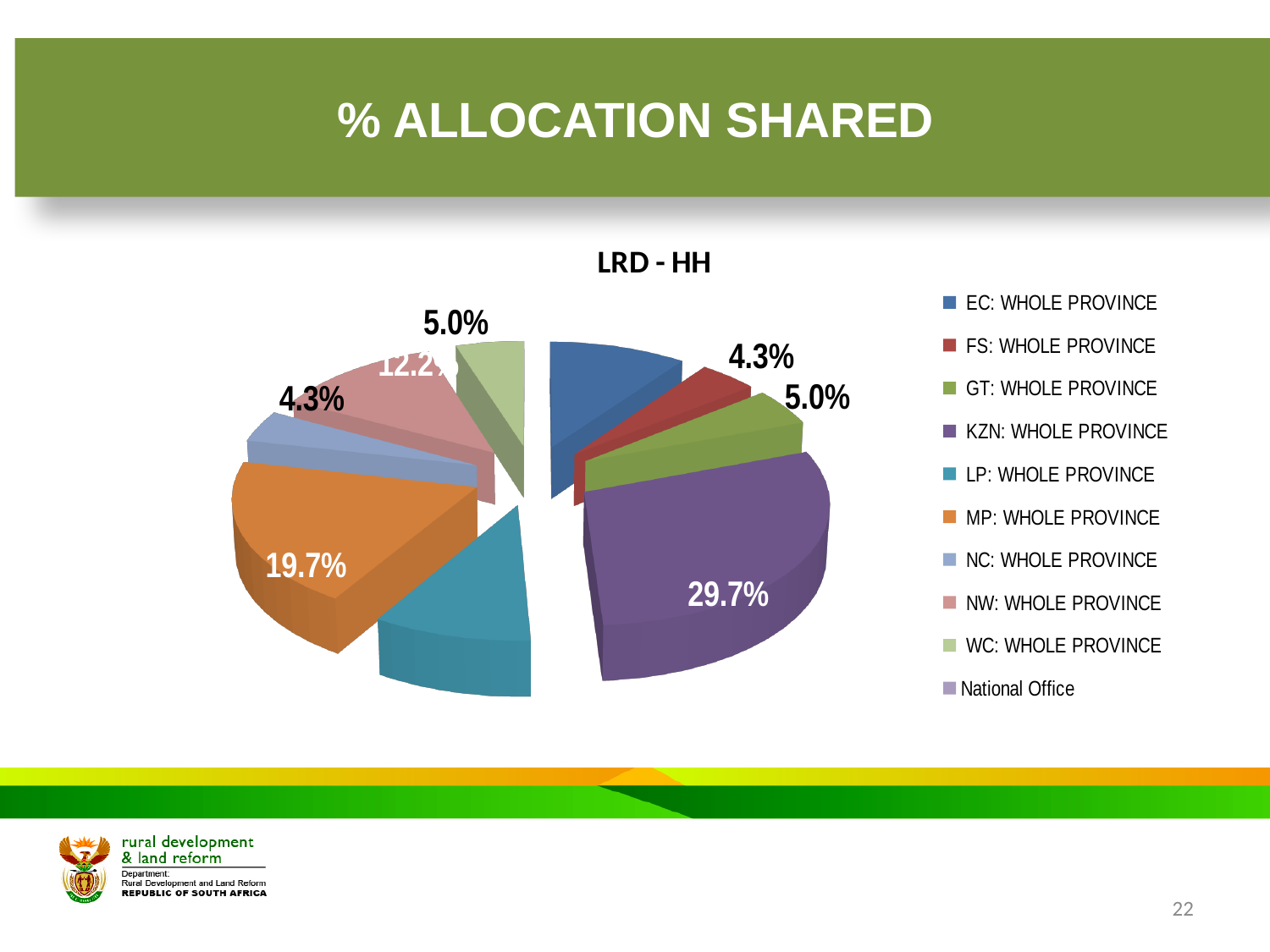
What share of the pie does WC: WHOLE PROVINCE have? 5.0% What share of the pie does GT: WHOLE PROVINCE have? 5.0% How many entries does the legend list? 10 What is the title of the pie chart? LRD - HH What share of the pie does KZN: WHOLE PROVINCE have? 29.7% Which slice is larger, GT: WHOLE PROVINCE or FS: WHOLE PROVINCE? GT: WHOLE PROVINCE What share of the pie does MP: WHOLE PROVINCE have? 19.7% What share of the pie does NC: WHOLE PROVINCE have? 4.3% What is the difference in percentage points between the KZN: WHOLE PROVINCE slice and the MP: WHOLE PROVINCE slice? 10.0 Which category has the largest slice of the pie? KZN: WHOLE PROVINCE What share of the pie does FS: WHOLE PROVINCE have? 4.3% What kind of chart is shown on the slide? pie chart